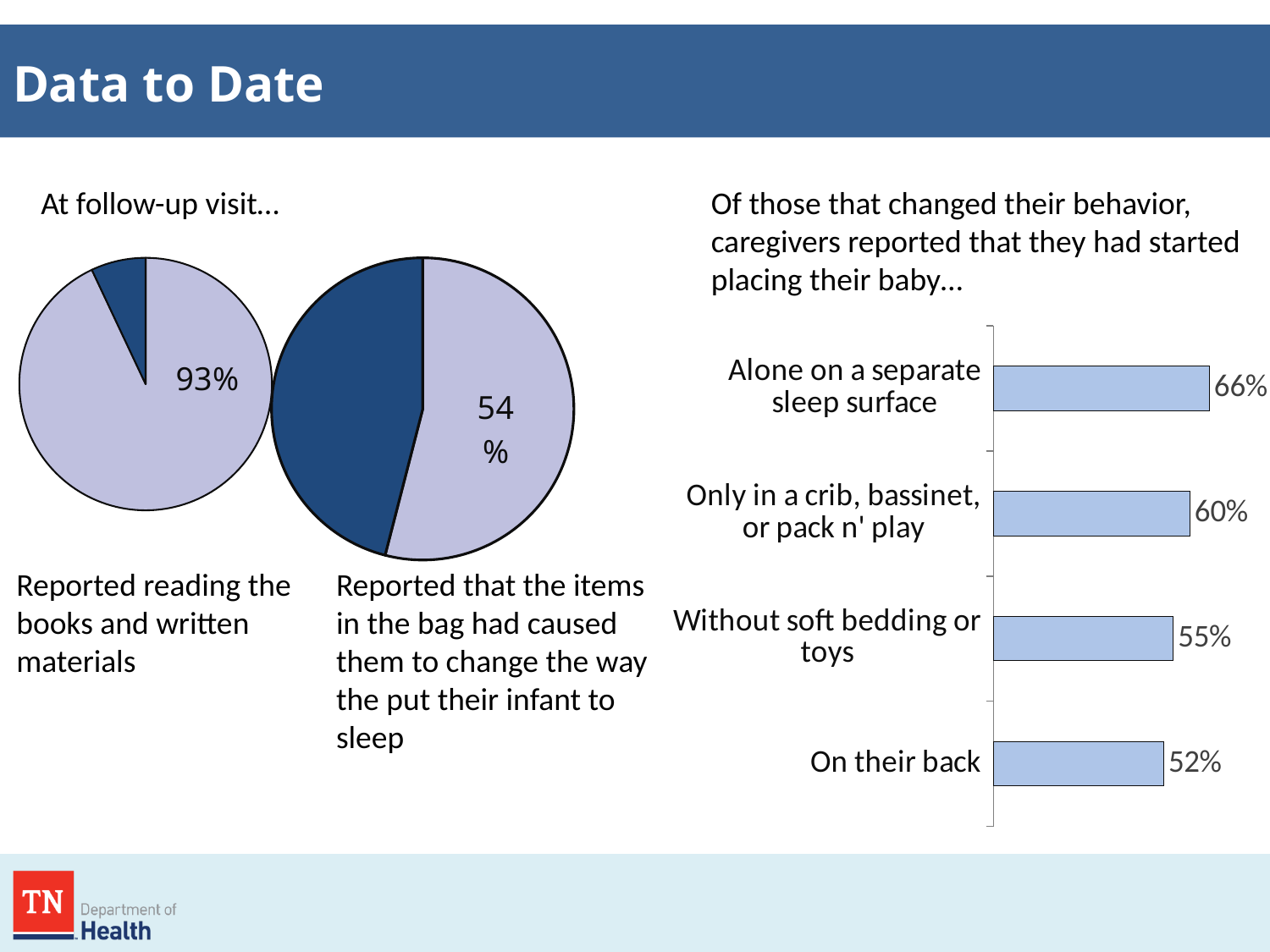
In the bar chart on the right, what percentage of caregivers reported placing their baby alone on a separate sleep surface? 66% In the bar chart on the right, which category has the highest value? Alone on a separate sleep surface In the second pie chart under 'At follow-up visit…', what percentage reported that the items in the bag had caused them to change the way they put their infant to sleep? 54% How many categories are shown in the bar chart on the right? 4 In the bar chart on the right, which is larger: 'Only in a crib, bassinet, or pack n' play' or 'Without soft bedding or toys'? Only in a crib, bassinet, or pack n' play What kind of charts are the two charts on the left side of the slide? Pie charts In the bar chart on the right, what is the difference between 'Alone on a separate sleep surface' and 'On their back'? 14% In the left pie chart under 'At follow-up visit…', what percentage reported reading the books and written materials? 93% What kind of chart is the chart on the right side of the slide? Bar chart In the bar chart on the right, which category has the lowest value? On their back In the bar chart on the right, what is the value for 'On their back'? 52% In the bar chart on the right, what is the value for 'Without soft bedding or toys'? 55%